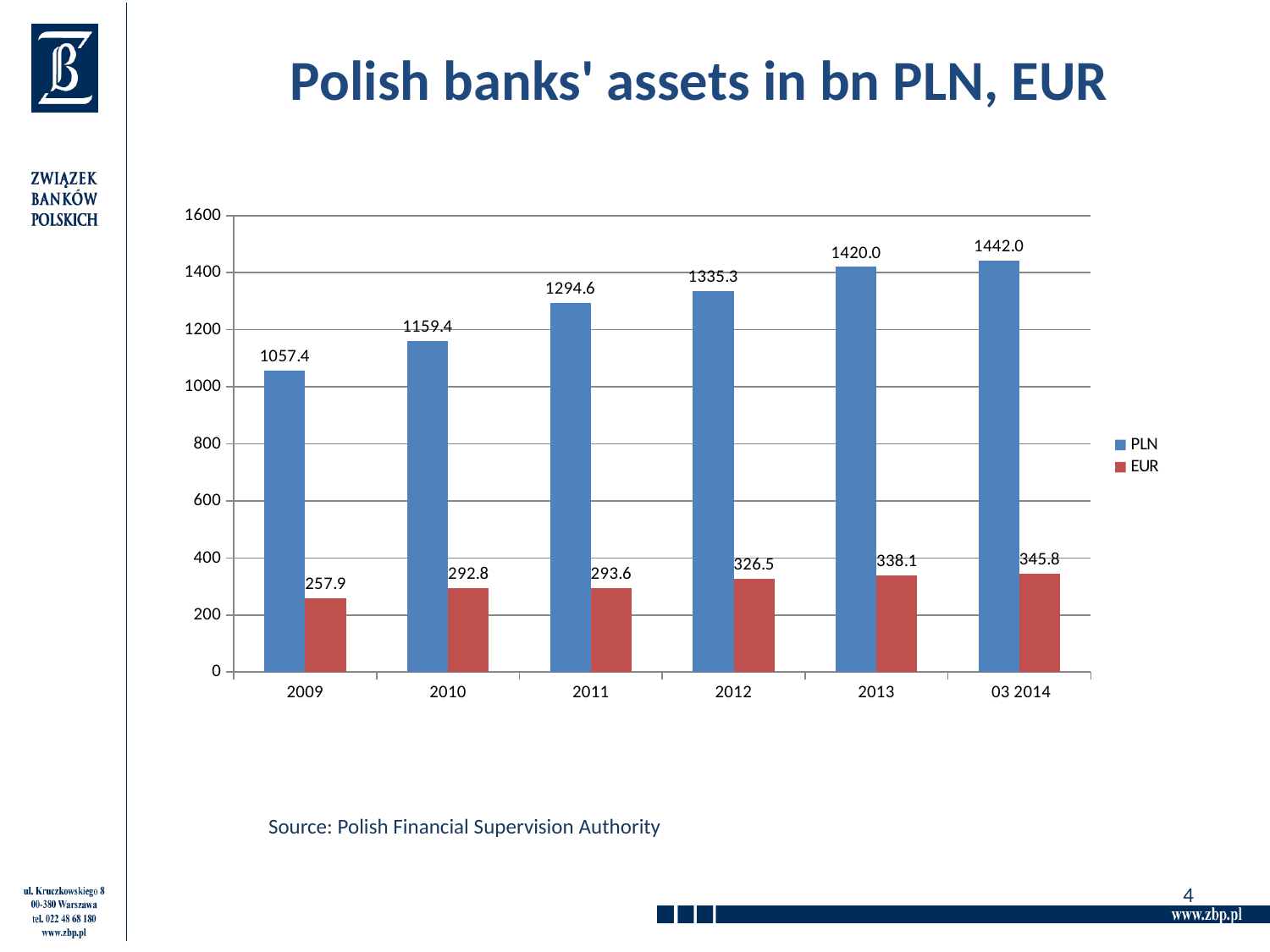
Which year has the lowest EUR value? 2009 How many series does the legend list? 2 What is the PLN value for 03 2014? 1442.0 What is the difference between the PLN values for 2013 and 2012? 84.7 What kind of chart is shown on the slide? bar chart What is the difference between the EUR values for 2010 and 2009? 34.9 How many categories are shown on the x axis? 6 Which is larger, the EUR value for 2012 or the EUR value for 2011? 2012 Do the PLN values rise or fall from 2009 to 03 2014? rise Which category has the highest PLN value? 03 2014 What is the PLN value for 2011? 1294.6 What is the EUR value for 2013? 338.1